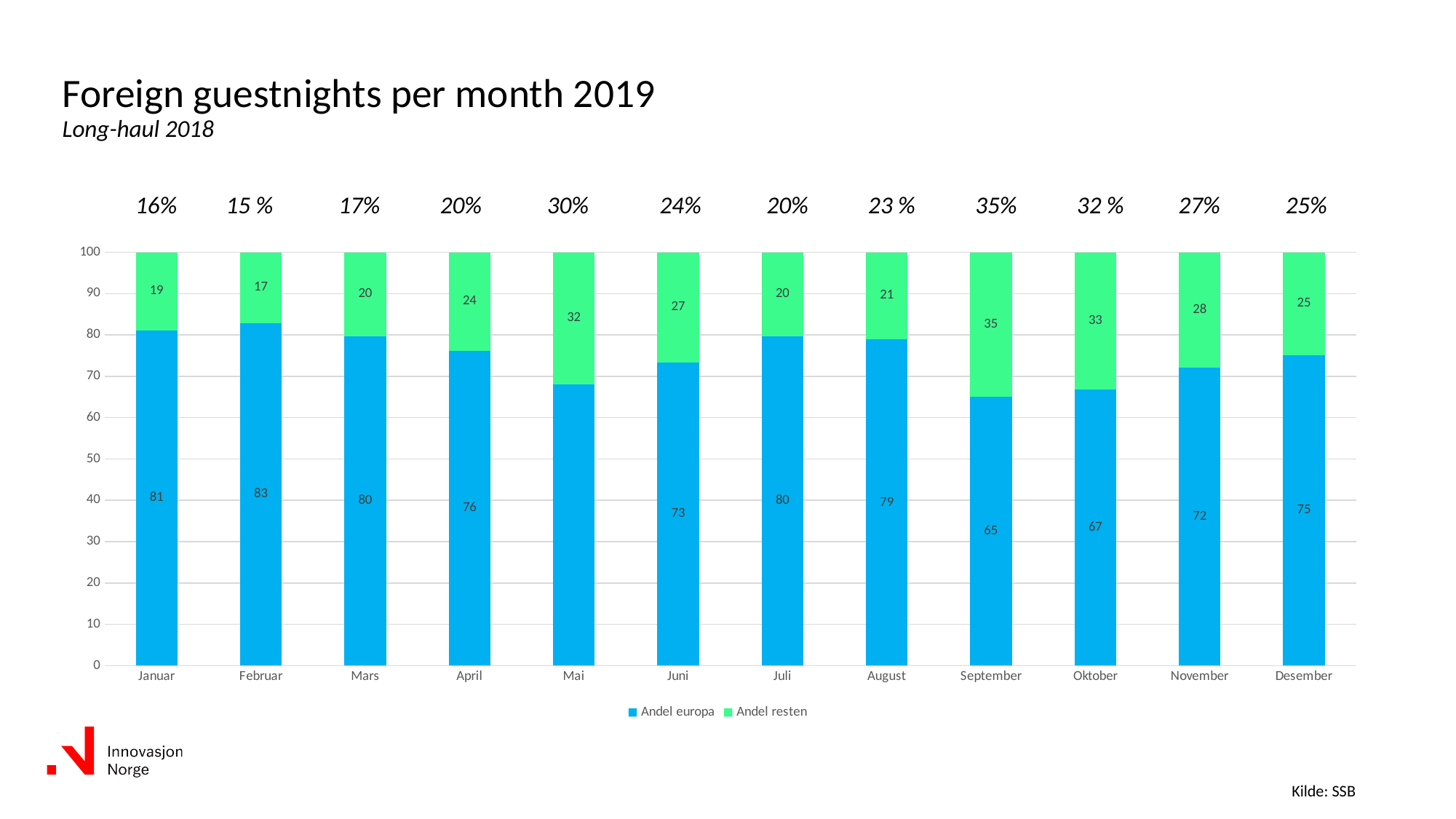
What is the total of the stacked bar for April? 100 What is the difference between the Andel resten values for Oktober and Januar? 14 Which month has the lowest Andel europa value? September What is the value of Andel resten for September? 35 Is the Andel europa value larger for Juni or for Desember? Desember What is the source cited at the bottom right of the slide? Kilde: SSB What is the value of Andel europa for Januar? 81 Which month has the highest Andel europa value? Februar How many months are shown on the x axis? 12 What kind of chart is shown on the slide? Stacked bar chart How many series does the legend list? 2